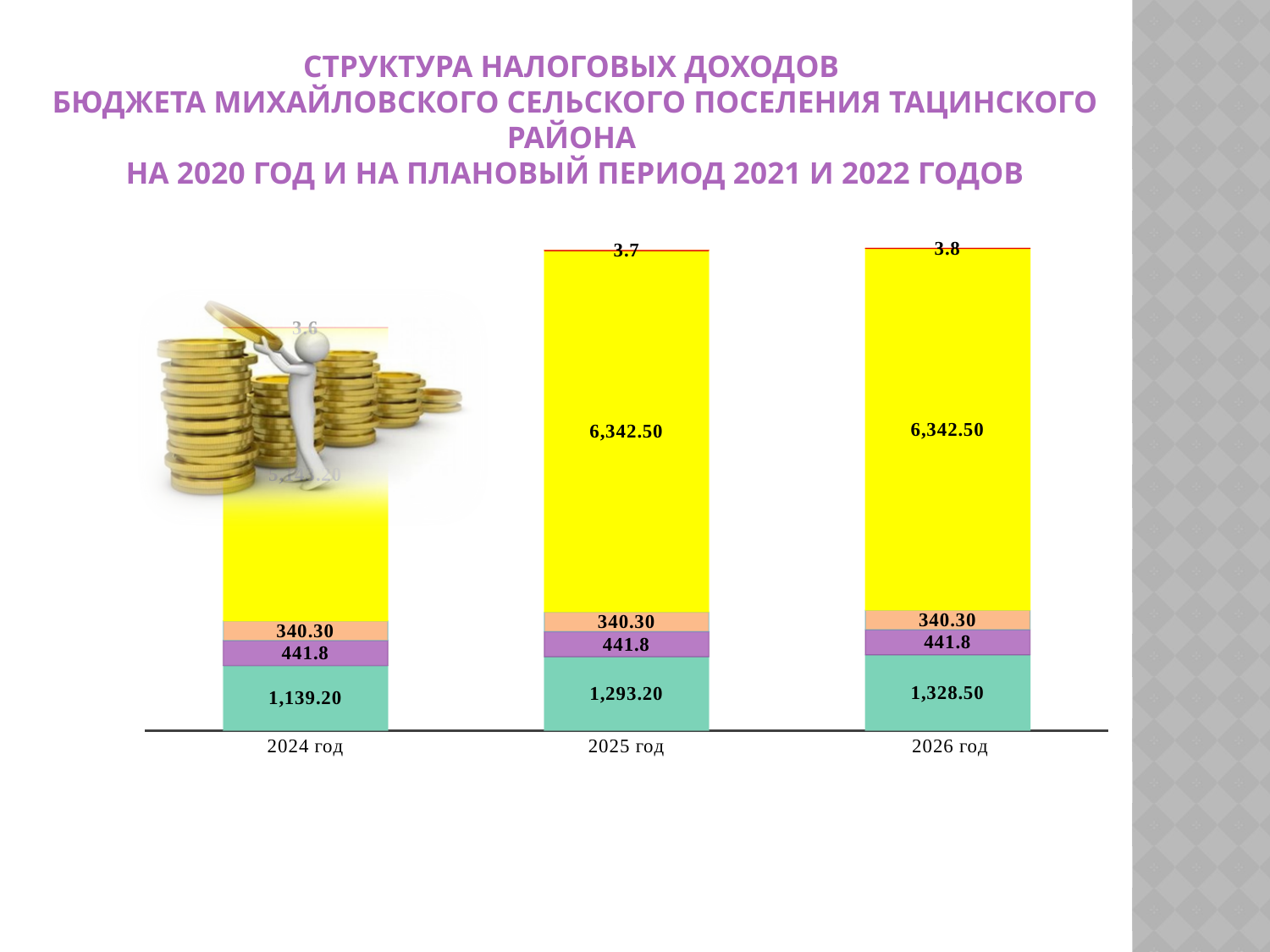
What is the value of the bottom (green) segment of the bar for 2025 год? 1,293.20 How many years (categories) are shown on the x axis of the chart? 3 What is the value of the large yellow segment of the bar for 2025 год? 6,342.50 What is the value of the bottom (green) segment of the bar for 2024 год? 1,139.20 What is the difference between the bottom (green) segment values for 2026 год and 2024 год? 189.30 What type of chart is shown on the slide? stacked bar chart Which year has the highest value for the bottom (green) segment? 2026 год What is the value of the orange segment of the bar for 2025 год? 340.30 What is the value of the bottom (green) segment of the bar for 2026 год? 1,328.50 What is the value of the purple segment of the bar for 2026 год? 441.8 What is the value labelled at the top of the bar for 2026 год? 3.8 Does the value of the bottom (green) segment rise or fall from 2024 год to 2026 год? rise